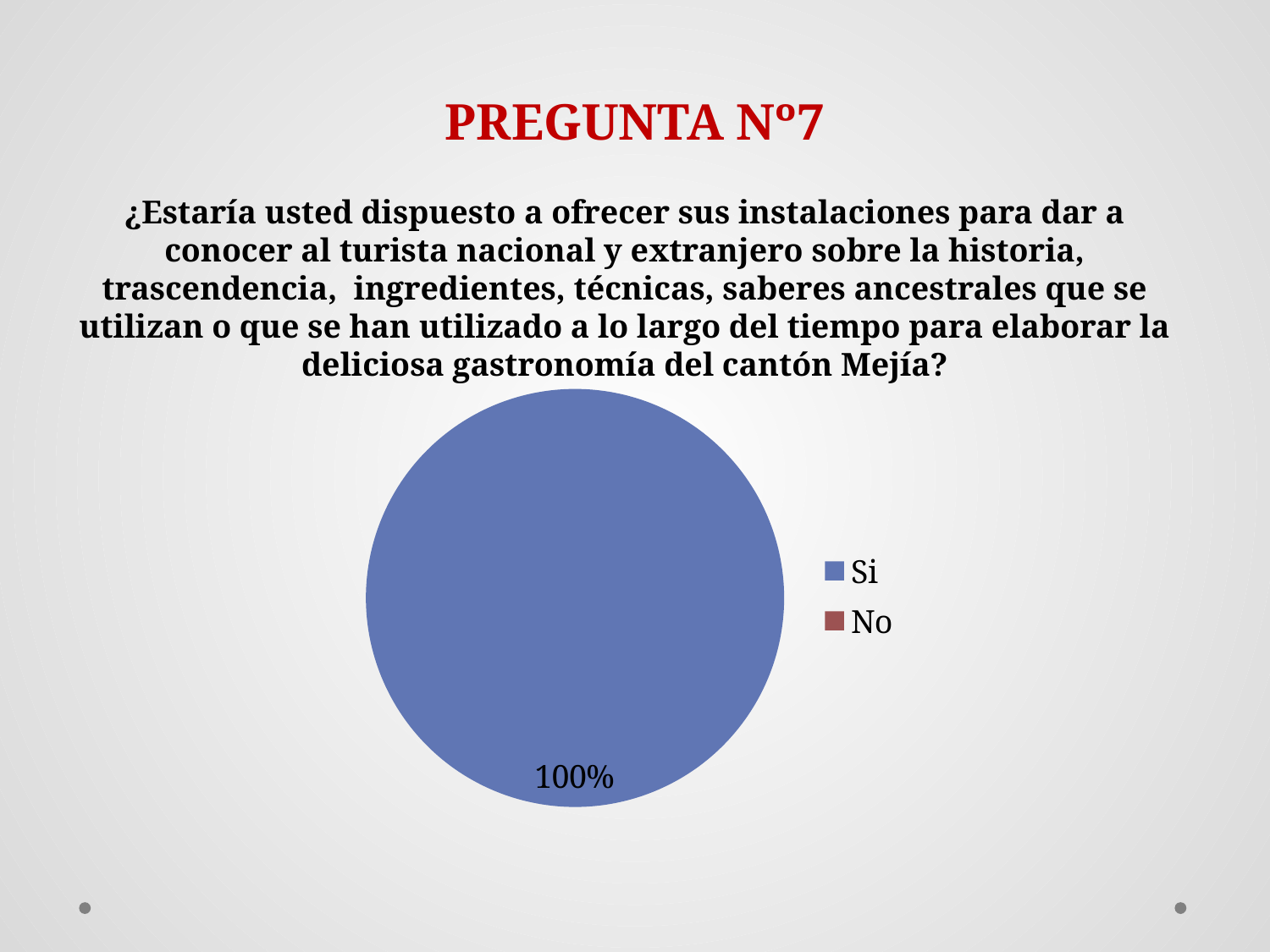
How many entries does the legend list? 2 What share of the pie does the "Si" slice represent? 100% Is the share for "Si" greater or less than 50%? greater What kind of chart is shown on the slide? pie chart Which of the two categories, Si or No, has the larger share? Si Which category has the largest share of the pie? Si What are the two legend entries of the chart? Si, No What colour is the "Si" slice in the pie chart? blue